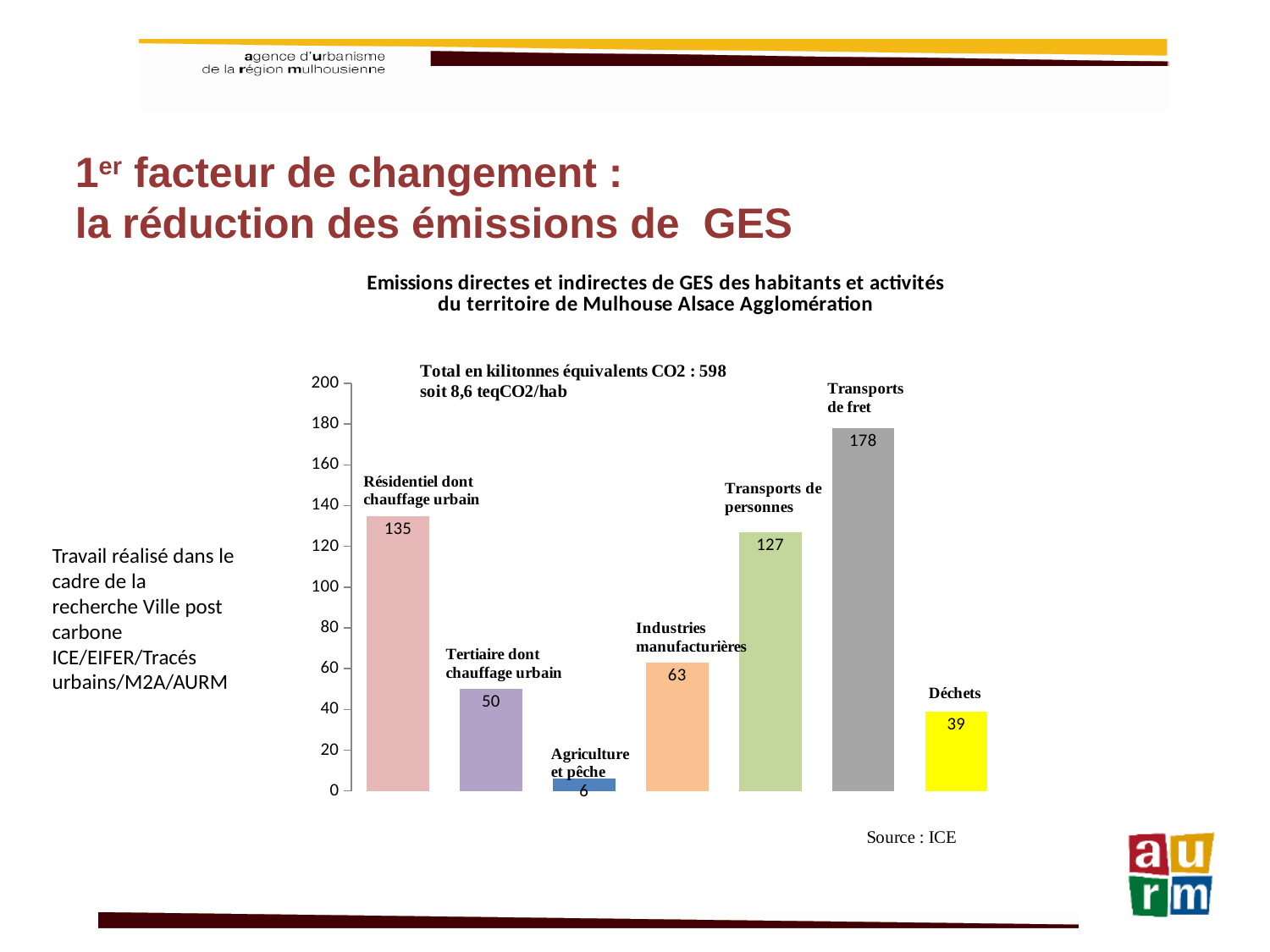
Which category has the highest value? Transports de fret What is the value for Agriculture et pêche? 6 What is the value for Transports de fret? 178 What is the value for Résidentiel dont chauffage urbain? 135 Which is larger, Industries manufacturières or Tertiaire dont chauffage urbain? Industries manufacturières What kind of chart is shown on the slide? bar chart What is the value for Déchets? 39 Is the value for Transports de personnes greater or less than 120? greater Which category has the lowest value? Agriculture et pêche What is the difference between Transports de fret and Transports de personnes? 51 How many categories are shown in the chart? 7 What total in kilotonnes équivalents CO2 is stated on the chart? 598